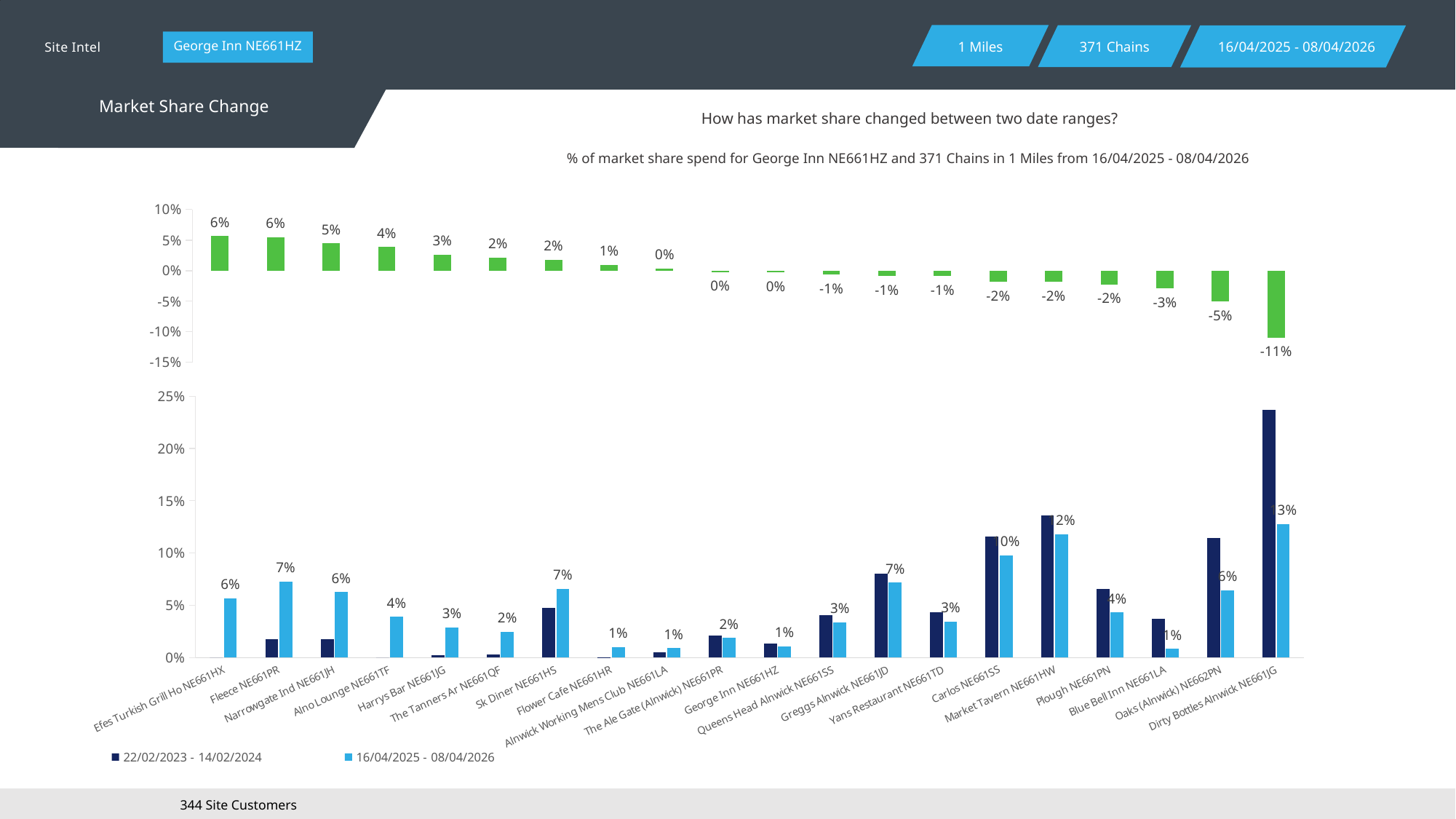
In the bottom chart, which has the larger 16/04/2025 - 08/04/2026 value, Fleece NE661PR or Alno Lounge NE661TF? Fleece NE661PR In the top chart, what is the market share change shown for Dirty Bottles Alnwick NE661JG? -11% In the bottom chart, which category has the highest 16/04/2025 - 08/04/2026 value? Dirty Bottles Alnwick NE661JG In the top chart, what is the market share change shown for Harrys Bar NE661JG? 3% In the top chart, which category has the lowest market share change? Dirty Bottles Alnwick NE661JG In the bottom chart, what is the 16/04/2025 - 08/04/2026 value for Carlos NE661SS? 10% What kind of chart is the bottom chart? bar chart In the bottom chart, what is the difference between the 16/04/2025 - 08/04/2026 values for Market Tavern NE661HW and Plough NE661PN? 8% How many categories are plotted in the top chart? 20 How many series does the legend of the bottom chart list? 2 In the top chart, do the values rise or fall from left to right along the x axis? fall In the bottom chart, is the 22/02/2023 - 14/02/2024 value for Dirty Bottles Alnwick NE661JG greater or less than 20%? greater